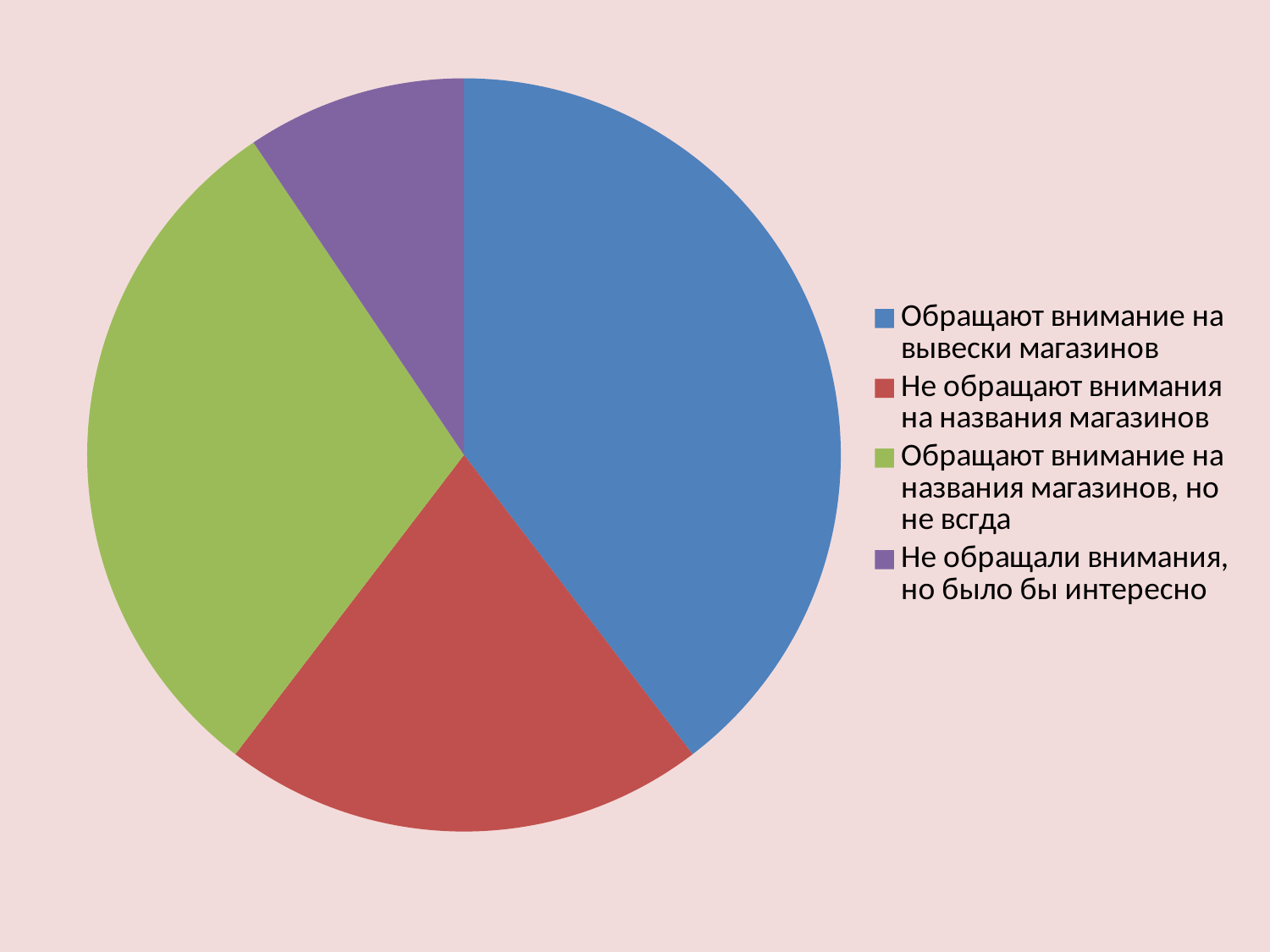
Which slice is larger: "Обращают внимание на названия магазинов, но не всгда" or "Не обращали внимания, но было бы интересно"? Обращают внимание на названия магазинов, но не всгда Which slice is larger: "Обращают внимание на вывески магазинов" or "Обращают внимание на названия магазинов, но не всгда"? Обращают внимание на вывески магазинов Which slice is larger: "Не обращают внимания на названия магазинов" or "Не обращали внимания, но было бы интересно"? Не обращают внимания на названия магазинов What colour is the slice for "Обращают внимание на названия магазинов, но не всгда"? green Which category has the smallest slice of the pie? Не обращали внимания, но было бы интересно How many slices does the pie chart have? 4 What kind of chart is shown on the slide? pie chart Which category has the largest slice of the pie? Обращают внимание на вывески магазинов How many entries does the legend list? 4 Which category is shown in blue in the pie chart? Обращают внимание на вывески магазинов